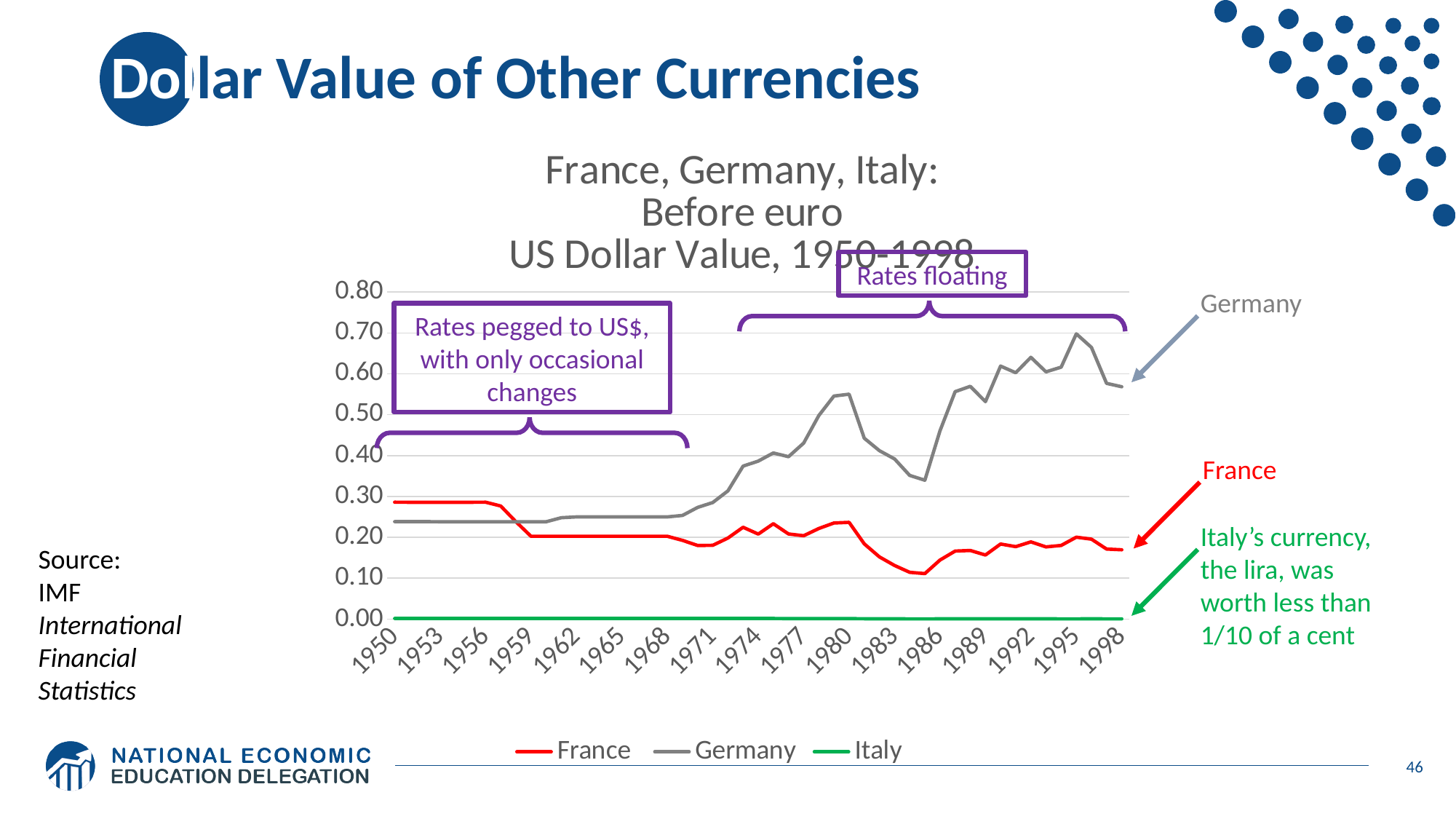
Which series has the highest value in 1998? Germany In 1998, which is larger, the value for France or the value for Germany? Germany What kind of chart is shown on the slide? Line chart Which series has the lowest value across the whole period? Italy Is the value for Germany in 1950 greater or less than 0.30? less What colour is the line for Germany? Grey Is the value for Germany in 1995 greater or less than 0.60? greater Does the value for Germany rise or fall overall from 1950 to 1998? Rise Which currencies are listed in the chart legend? France, Germany, Italy Is the value for Italy in 1980 greater or less than 0.10? less How many series does the legend list? 3